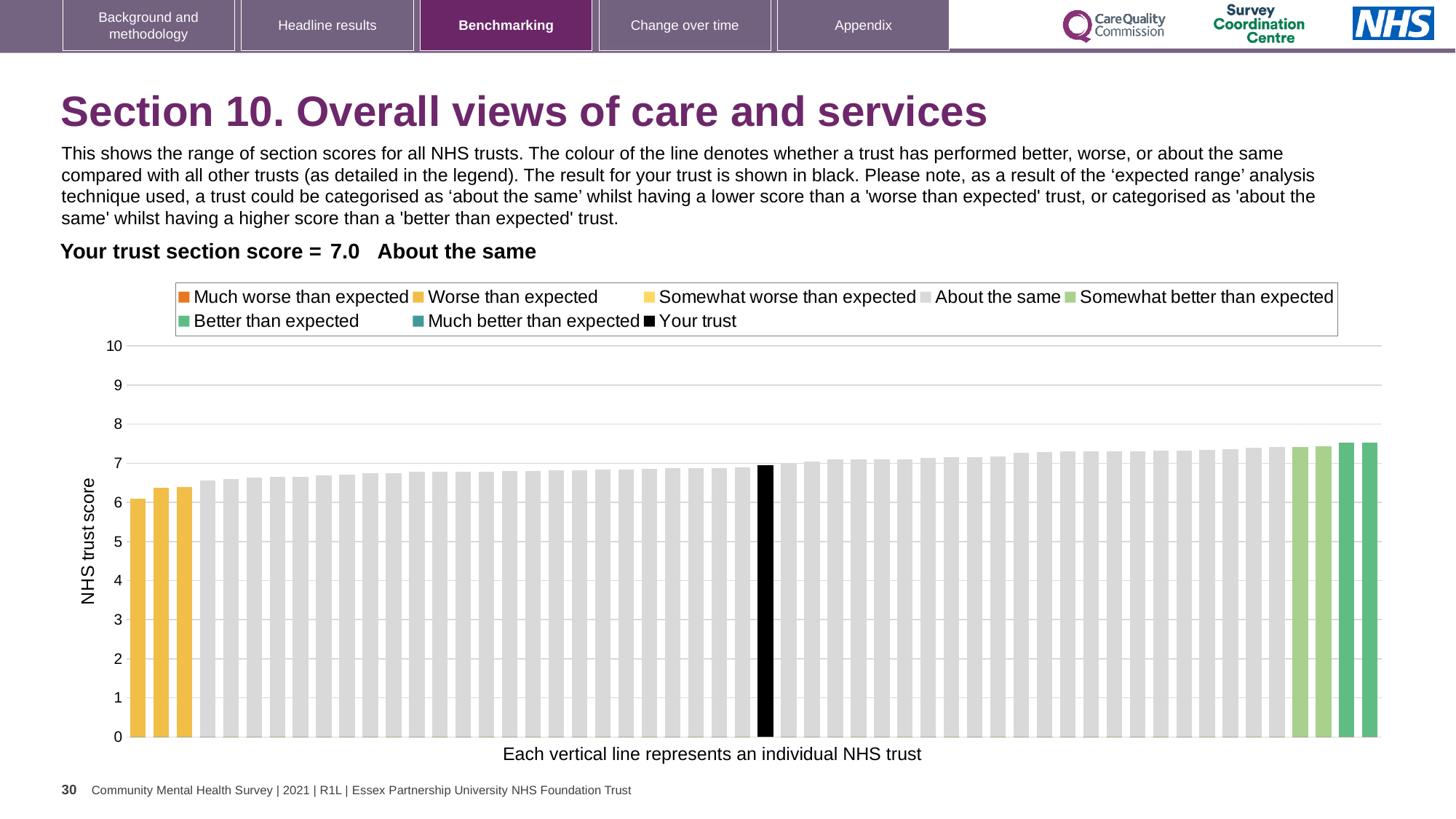
Which is larger, the leftmost bar or the rightmost bar? the rightmost bar What kind of chart is shown on the slide? bar chart What is the section score for your trust shown on the slide? 7.0 How many entries does the chart legend list? 8 Which legend category does the tallest bar belong to? Better than expected Is the value of the leftmost (lowest) bar greater or less than 7? less Is the value of the rightmost (highest) bar greater or less than 7? greater Do the bar values rise or fall from left to right along the x axis? rise What colour is the bar representing your trust? black How many bars are coloured as 'Worse than expected' (yellow)? 3 Is the value of the rightmost (highest) bar greater or less than 8? less